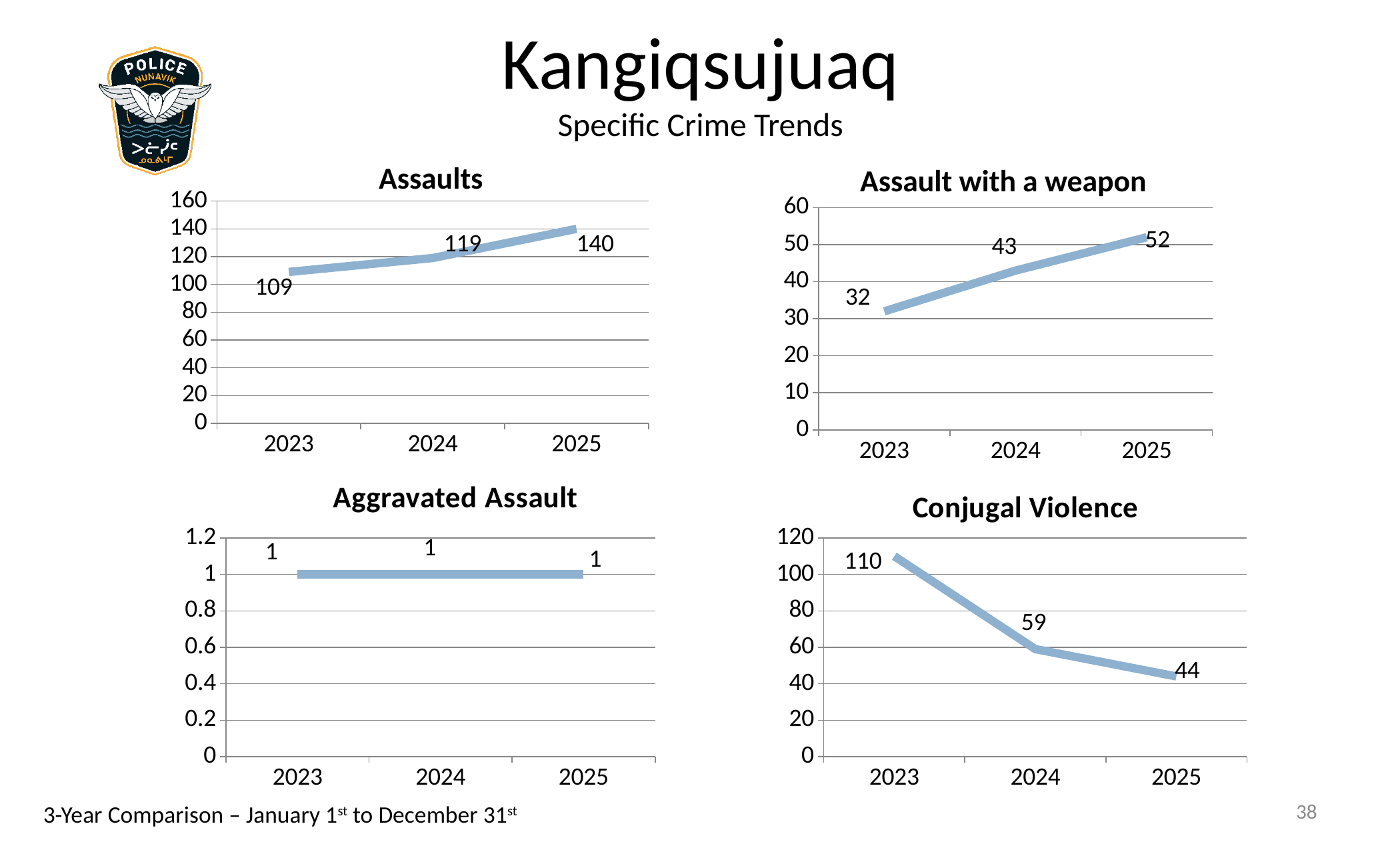
In the Assault with a weapon chart, what is the value for 2024? 43 In the Assaults chart, which year has the lowest value? 2023 In the Assault with a weapon chart, do the values rise or fall from 2023 to 2025? rise What kind of chart is the Conjugal Violence chart? line chart In the Conjugal Violence chart, what is the value for 2023? 110 In the Aggravated Assault chart, what is the value for 2024? 1 In the Assaults chart, what is the difference between the 2025 and 2023 values? 31 In the Conjugal Violence chart, is the value for 2024 larger or smaller than the value for 2025? larger In the Aggravated Assault chart, how many years are plotted? 3 In the Conjugal Violence chart, which year has the highest value? 2023 In the Assault with a weapon chart, what is the difference between the 2025 and 2023 values? 20 In the Assaults chart, what is the value for 2025? 140